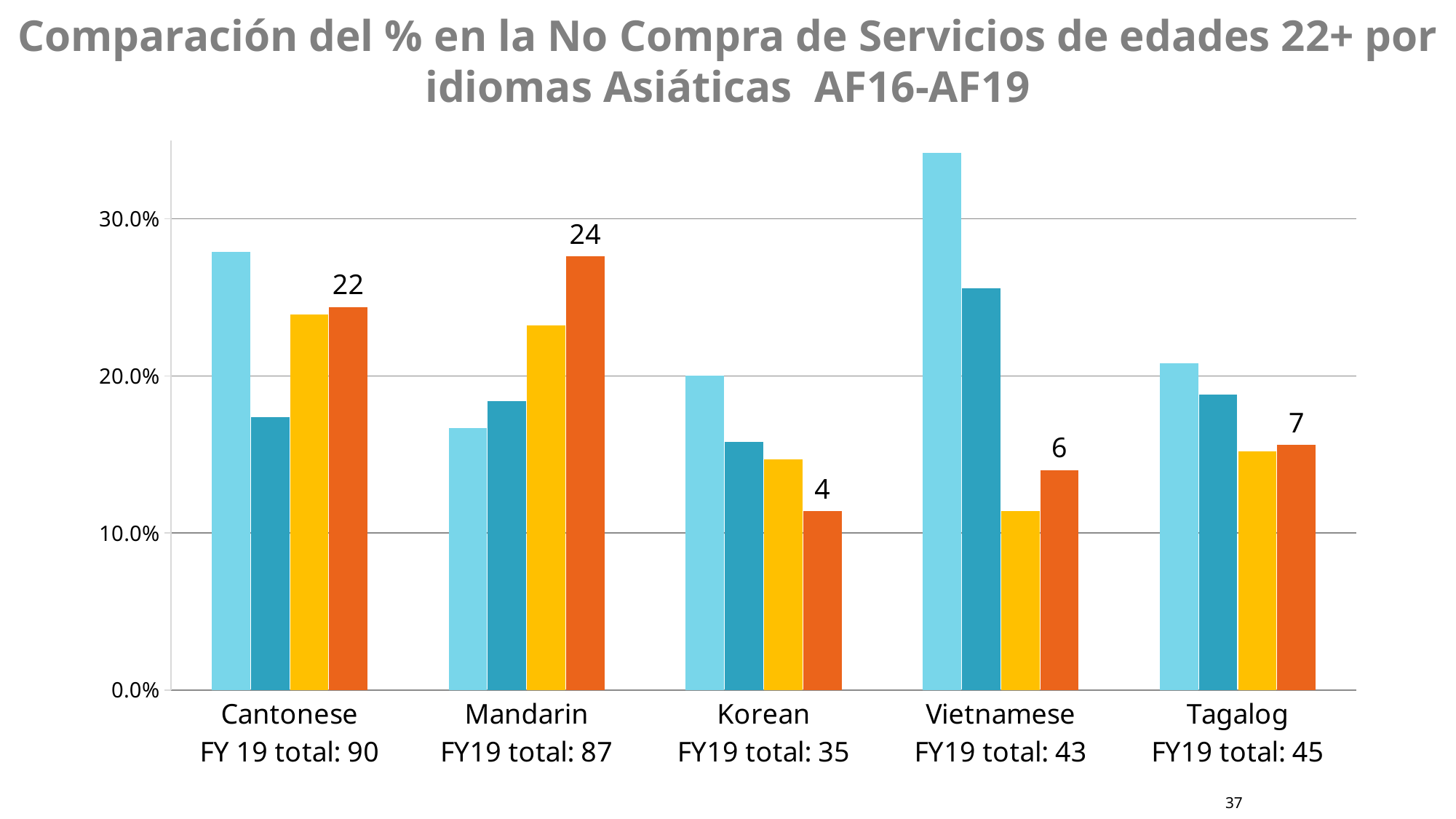
What FY19 total is shown under the Cantonese category label? 90 How many bars are plotted for each language category? 4 How many language categories are shown on the x axis? 5 What number is printed above the orange bar for Mandarin? 24 Which language category has the tallest bar in the chart? Vietnamese What kind of chart is shown on the slide? bar chart Which language category has the lowest orange bar? Korean What number is printed above the orange bar for Vietnamese? 6 Which is higher, the orange bar for Mandarin or the orange bar for Cantonese? Mandarin Is the value of the light blue bar for Vietnamese greater or less than 30.0%? greater Is the value of the yellow bar for Vietnamese greater or less than 20.0%? less What FY19 total is shown under the Korean category label? 35